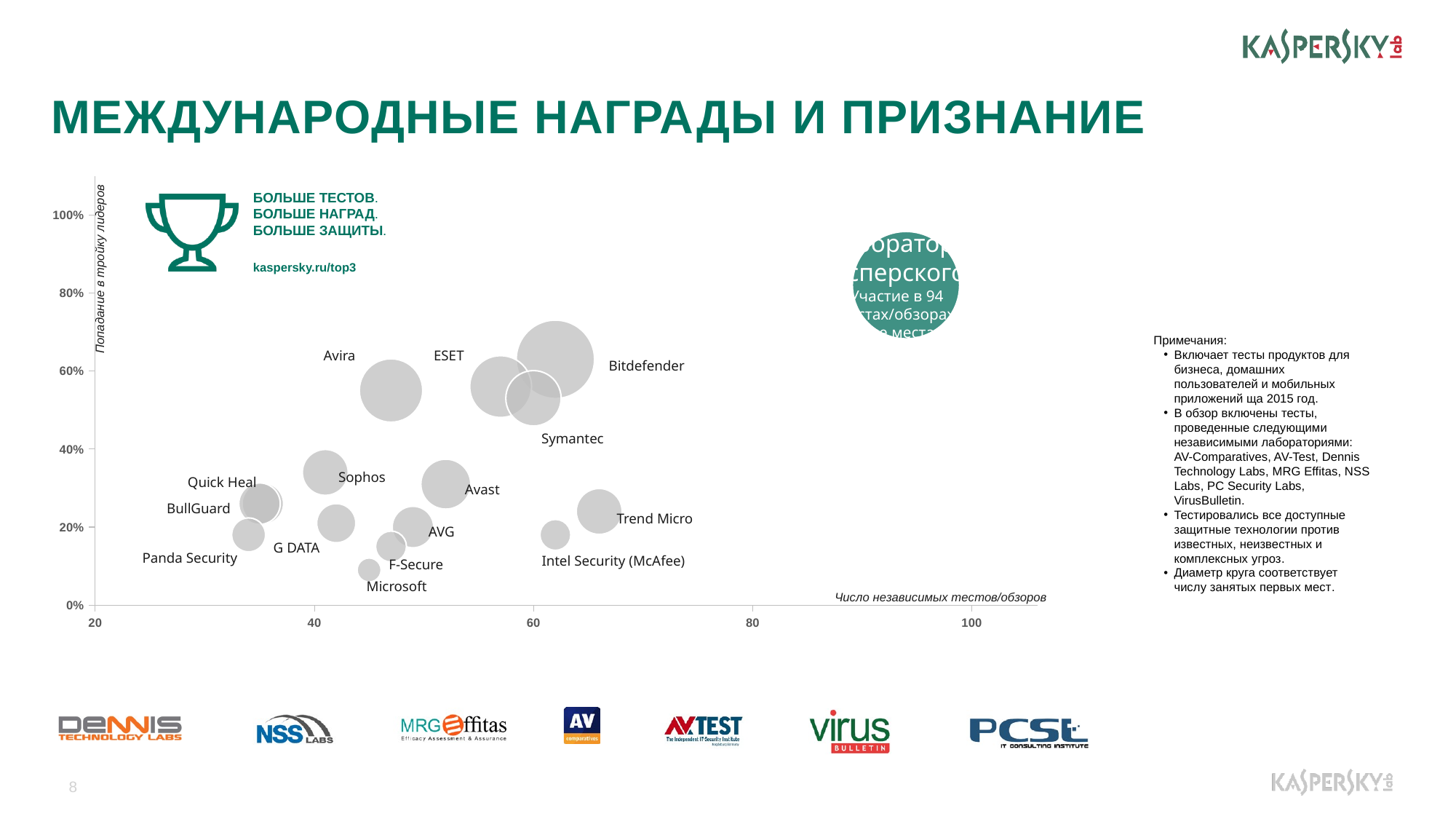
Is the value on the y axis for Avira greater or less than 40%? greater What kind of chart is shown on the slide? bubble chart Which vendor has the lowest value on the y axis? Microsoft Is the value on the y axis for Bitdefender greater or less than 40%? greater What is the label of the x axis of the chart? Число независимых тестов/обзоров Is the value on the x axis for Trend Micro greater or less than 60? greater What is the label of the y axis of the chart? Попадание в тройку лидеров Among the grey bubbles, which vendor is furthest to the right on the x axis? Trend Micro Which has the higher value on the y axis, Trend Micro or Intel Security (McAfee)? Trend Micro Among the grey bubbles, which vendor has the highest value on the y axis? Bitdefender